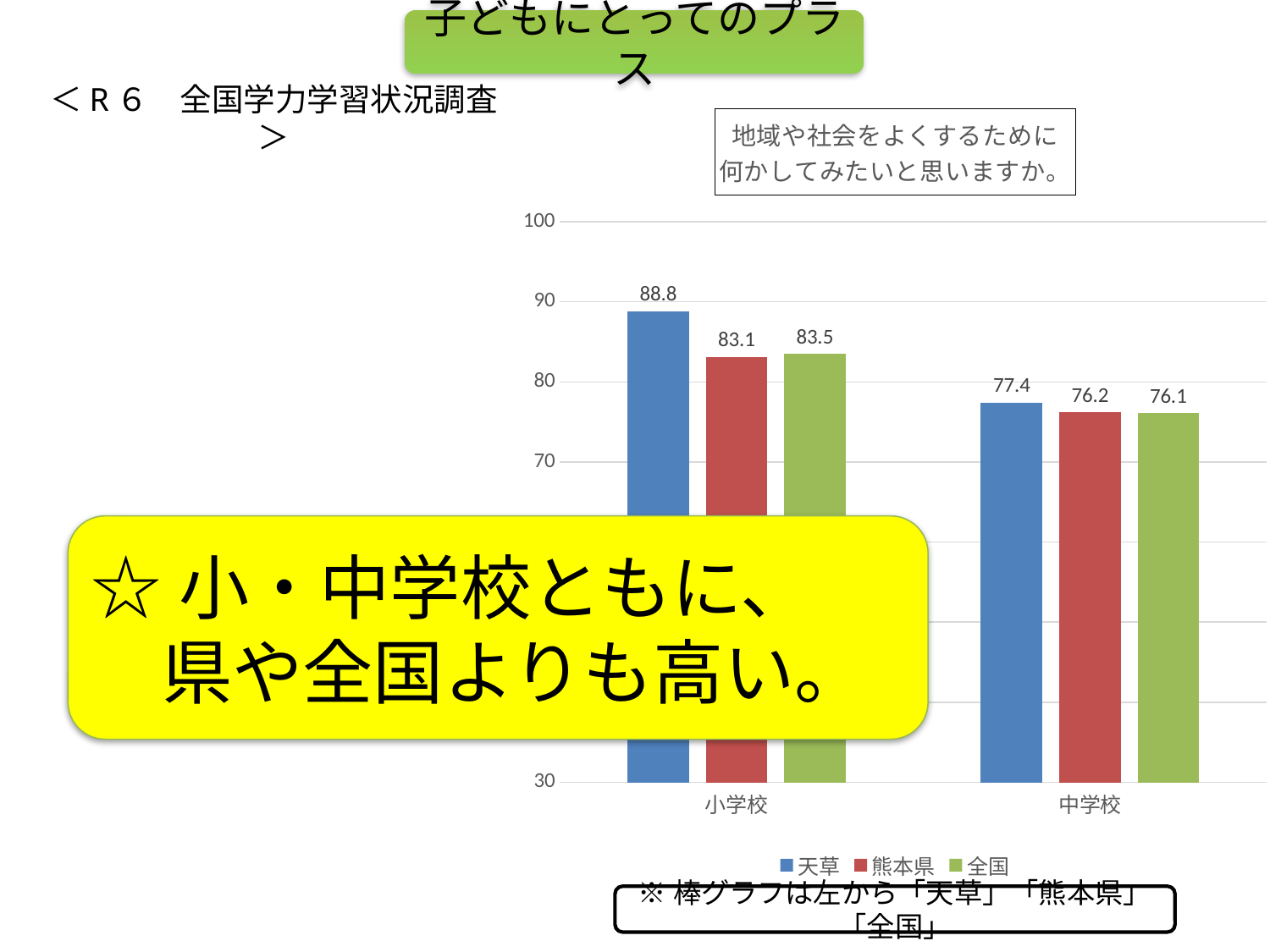
What is the difference between the 天草 and 熊本県 values in the 小学校 category? 5.7 How many series does the legend list? 3 What is the difference between the 天草 values for 小学校 and 中学校? 11.4 What kind of chart is shown on the slide? bar chart Which is larger, the 天草 value for 小学校 or the 天草 value for 中学校? 小学校 Which series has the lowest value in the 小学校 category? 熊本県 How many categories are shown on the x axis? 2 What is the value for 全国 in the 小学校 category? 83.5 Which series has the highest value in the 小学校 category? 天草 What colour are the bars for the 全国 series? green What is the value for 熊本県 in the 中学校 category? 76.2 What is the value for 天草 in the 小学校 category? 88.8